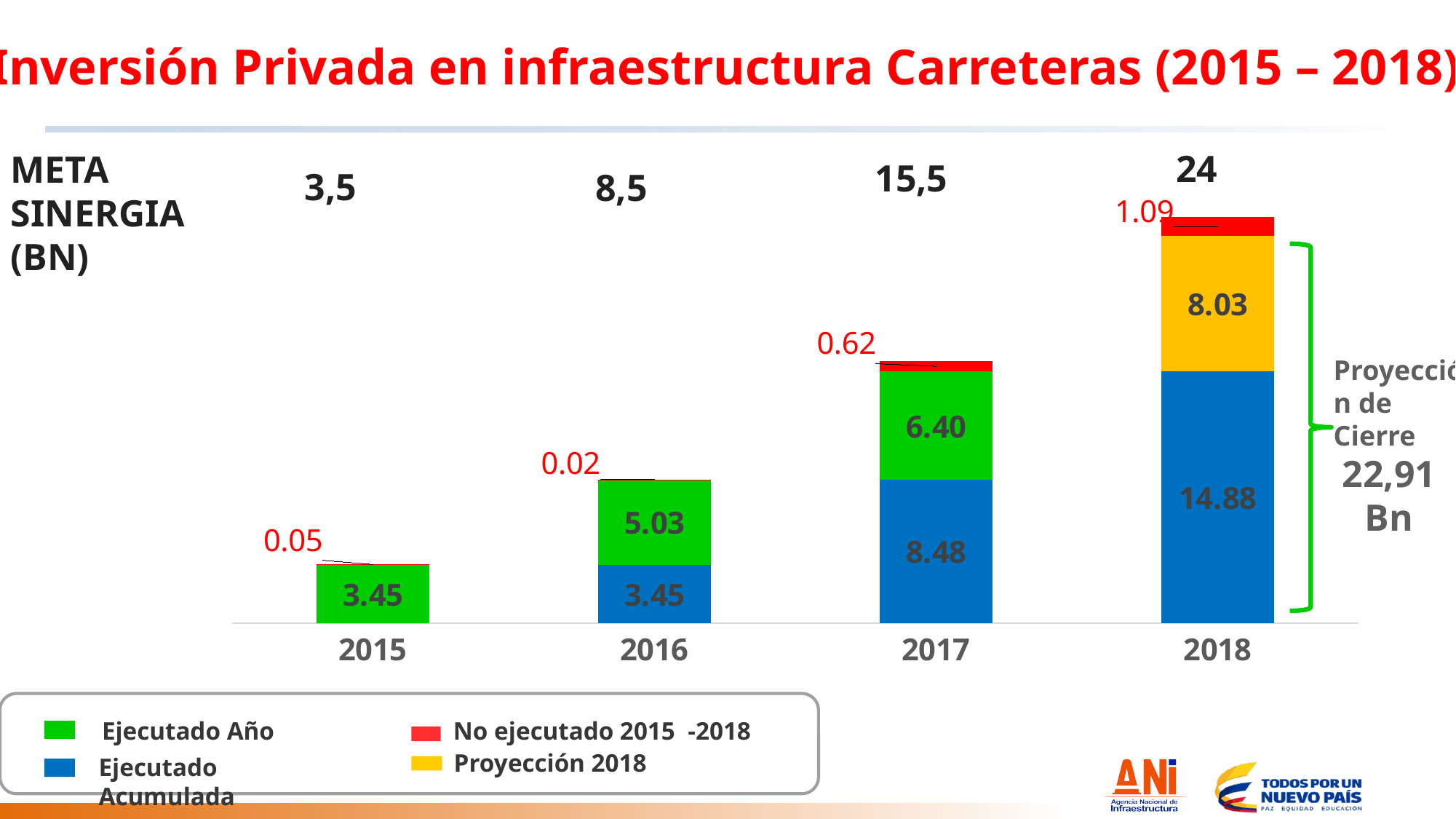
What is the META SINERGIA (BN) value shown for 2017? 15,5 What is the Proyección 2018 value in the 2018 bar? 8.03 What is the difference between the Ejecutado Año values for 2017 and 2016? 1.37 How many series does the legend list? 4 What is the total of the stacked bar for 2018 (14.88 + 8.03 + 1.09)? 24.00 Which year has the highest Ejecutado Acumulada value? 2018 What is the No ejecutado value shown above the 2017 bar? 0.62 What type of chart is shown on the slide? Stacked bar chart What is the Ejecutado Año value for 2016? 5.03 Which year has the lowest No ejecutado value? 2016 What is the Ejecutado Acumulada value for 2018? 14.88 Is the Ejecutado Año value for 2017 larger or smaller than the Ejecutado Acumulada value for 2017? smaller